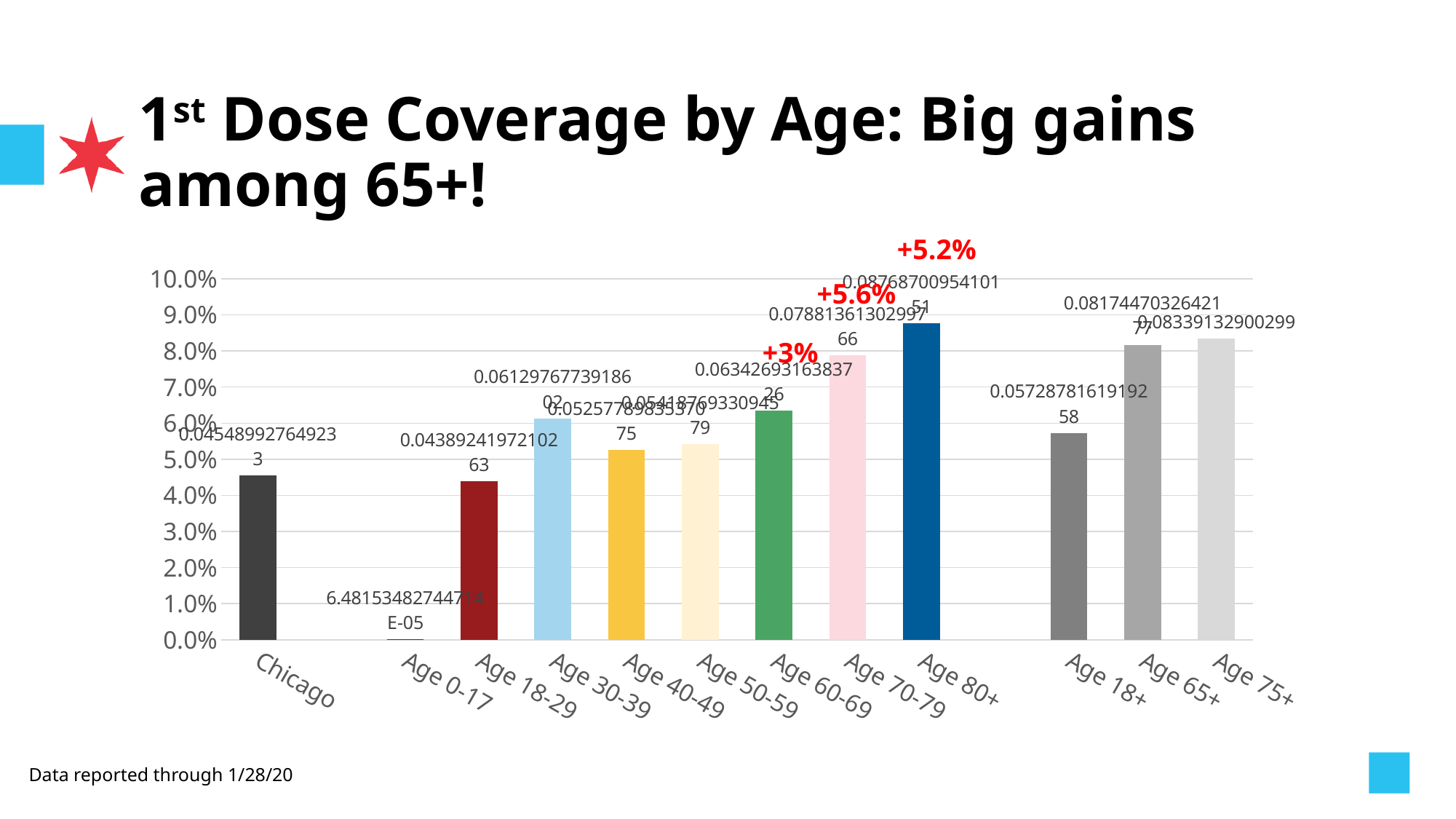
Which category has the highest 1st dose coverage? Age 80+ What kind of chart is shown on the slide? bar chart Do the values rise or fall from Age 18-29 through Age 80+? rise Which category has the lowest 1st dose coverage? Age 0-17 Is the value for Age 18+ greater or less than 5.0%? greater Is the value for Age 80+ greater or less than 8.0%? greater What gain is annotated in red above the Age 80+ bar? +5.2% How many categories are plotted along the x axis? 12 Which is larger, the value for Age 70-79 or the value for Age 60-69? Age 70-79 Is the value for Chicago greater or less than 5.0%? less Which is larger, the value for Age 18+ or the value for Chicago? Age 18+